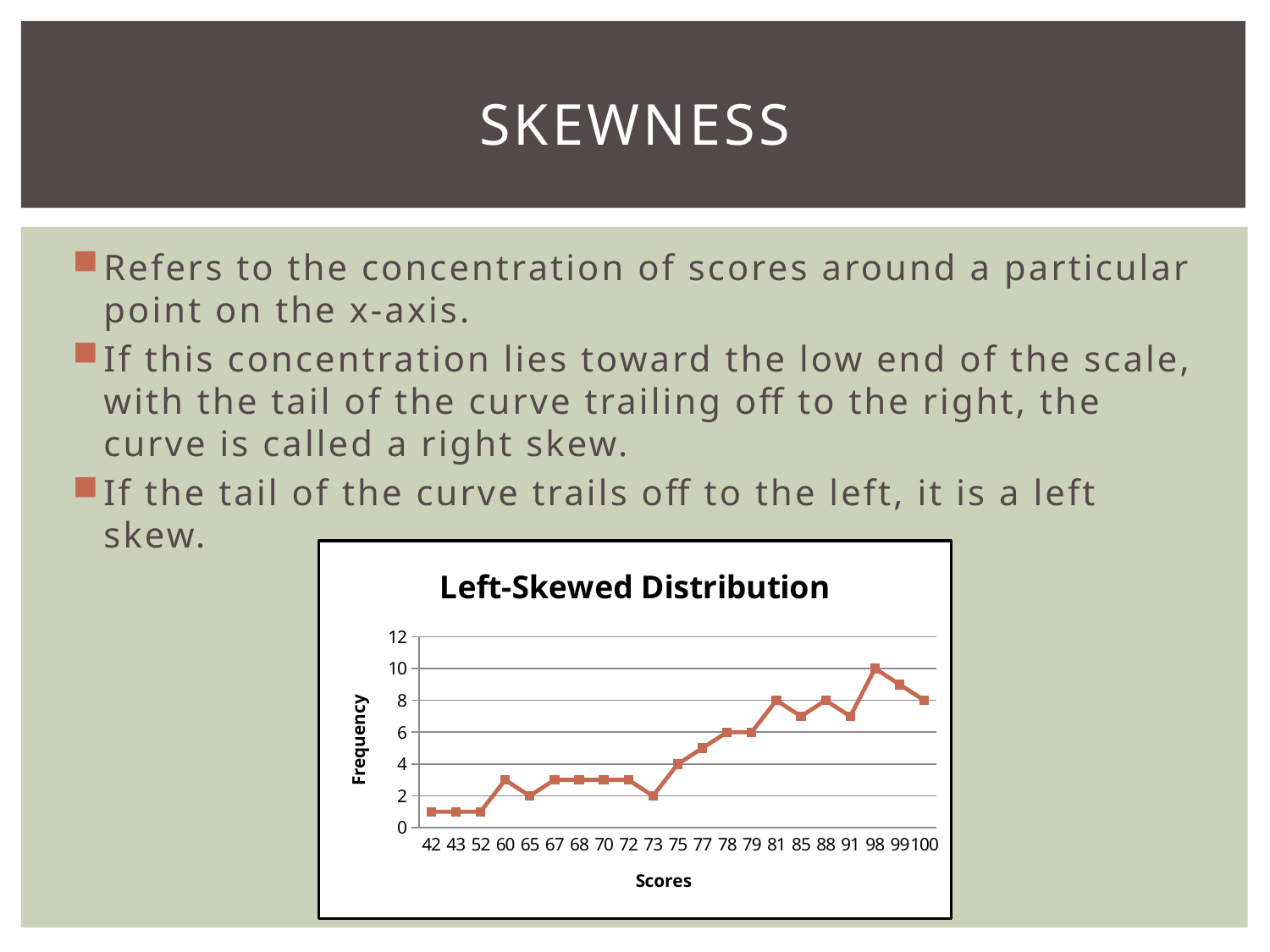
How many score categories are plotted along the x-axis? 21 Is the frequency for a score of 91 greater or less than 6? greater What is the label of the y-axis of the chart? Frequency What is the frequency for a score of 78? 6 Which score has the highest frequency? 98 What is the difference in frequency between scores 98 and 100? 2 What is the frequency for a score of 75? 4 What is the frequency for a score of 98? 10 What is the title of the chart? Left-Skewed Distribution What is the frequency for a score of 100? 8 What type of chart is shown on the slide? line chart Which has a higher frequency, score 98 or score 81? 98